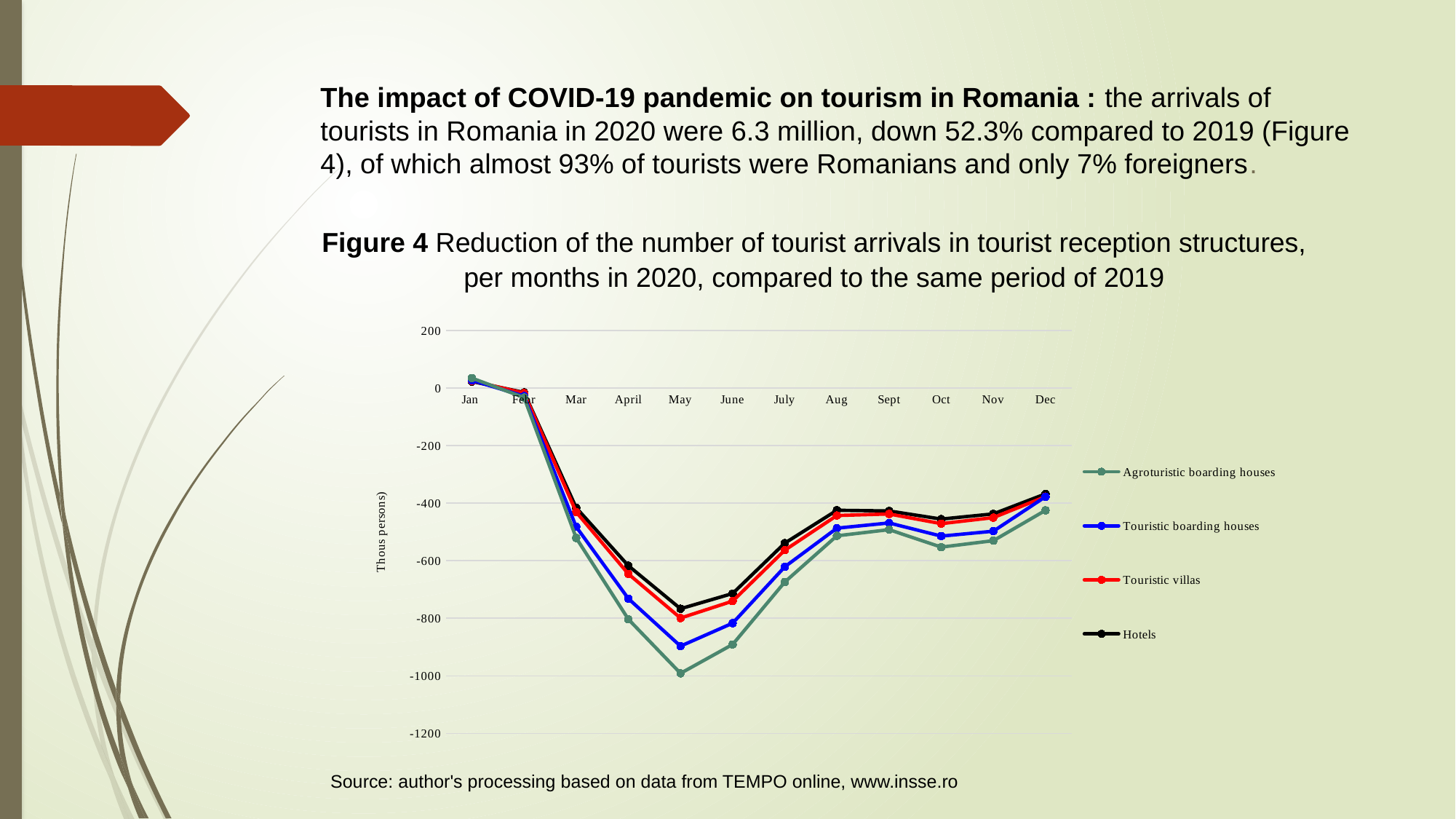
Which series has the lowest value in May? Agroturistic boarding houses Is the value for Hotels in May greater or less than -800? greater How many series does the legend of the chart list? 4 What is the label on the vertical axis of the chart? Thous persons Which series has the highest value in May? Hotels In October, which is larger: the value for Touristic villas or the value for Agroturistic boarding houses? Touristic villas Do the values of the Hotels series rise or fall from May to August? rise In which month does the Agroturistic boarding houses series reach its lowest value? May What kind of chart is shown in Figure 4? line chart How many months are plotted along the x axis of the chart? 12 Is the value for Agroturistic boarding houses in May greater or less than -800? less Is the value for Agroturistic boarding houses in July greater or less than -600? less